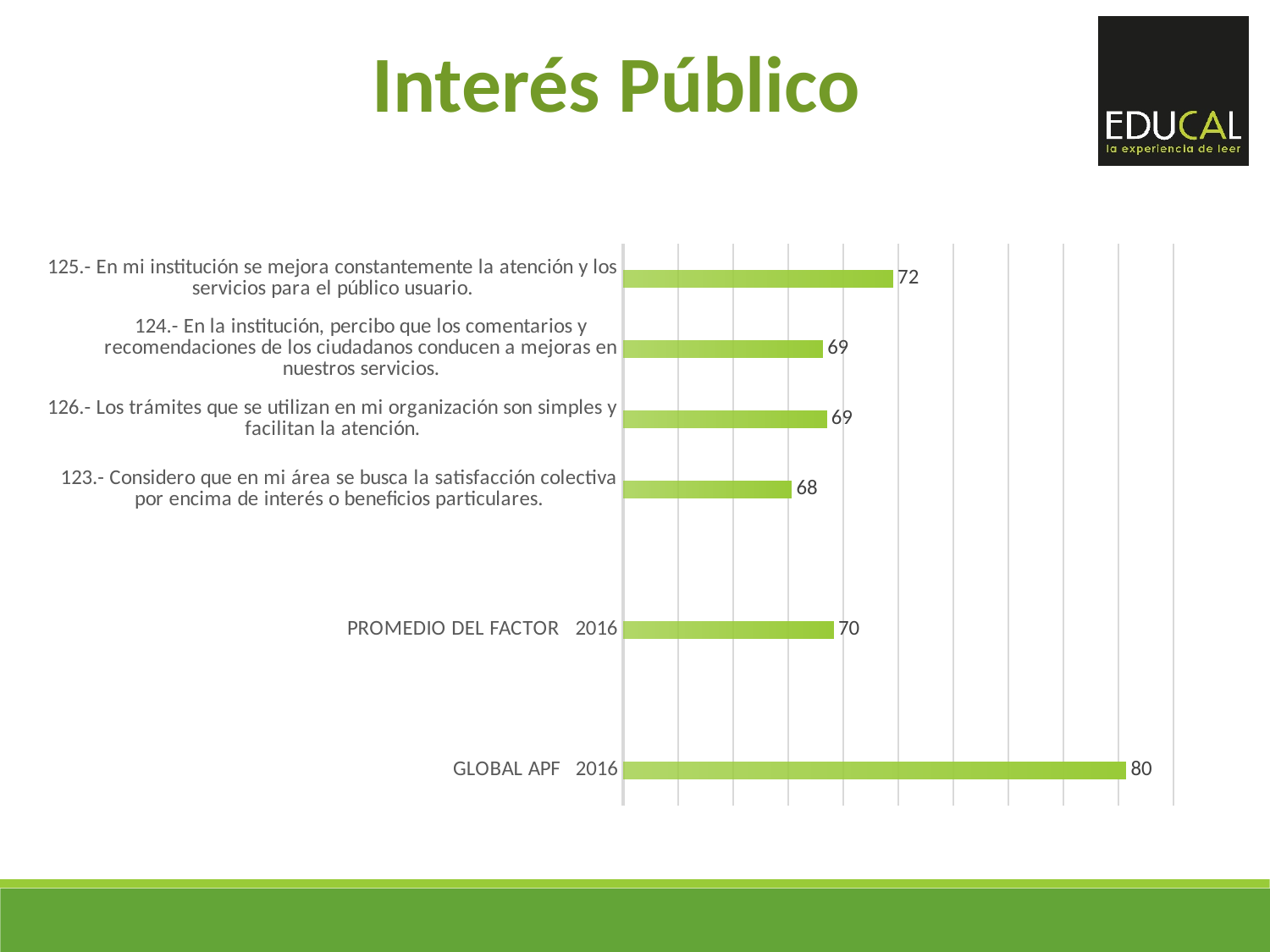
Which category has the lowest value? 123.- Considero que en mi área se busca la satisfacción colectiva por encima de interés o beneficios particulares. What is the value for GLOBAL APF 2016? 80 What kind of chart is shown on the slide? Bar chart How many bars are shown in the chart? 6 What is the value for item 126 (Los trámites que se utilizan en mi organización son simples y facilitan la atención)? 69 What is the difference between item 125 and item 123? 4 What is the value for PROMEDIO DEL FACTOR 2016? 70 What is the value for item 123 (Considero que en mi área se busca la satisfacción colectiva por encima de interés o beneficios particulares)? 68 Which category has the highest value? GLOBAL APF 2016 Which is larger, the value for item 125 or the value for PROMEDIO DEL FACTOR 2016? 125.- En mi institución se mejora constantemente la atención y los servicios para el público usuario. What is the value for item 125 (En mi institución se mejora constantemente la atención y los servicios para el público usuario)? 72 What is the difference between GLOBAL APF 2016 and PROMEDIO DEL FACTOR 2016? 10